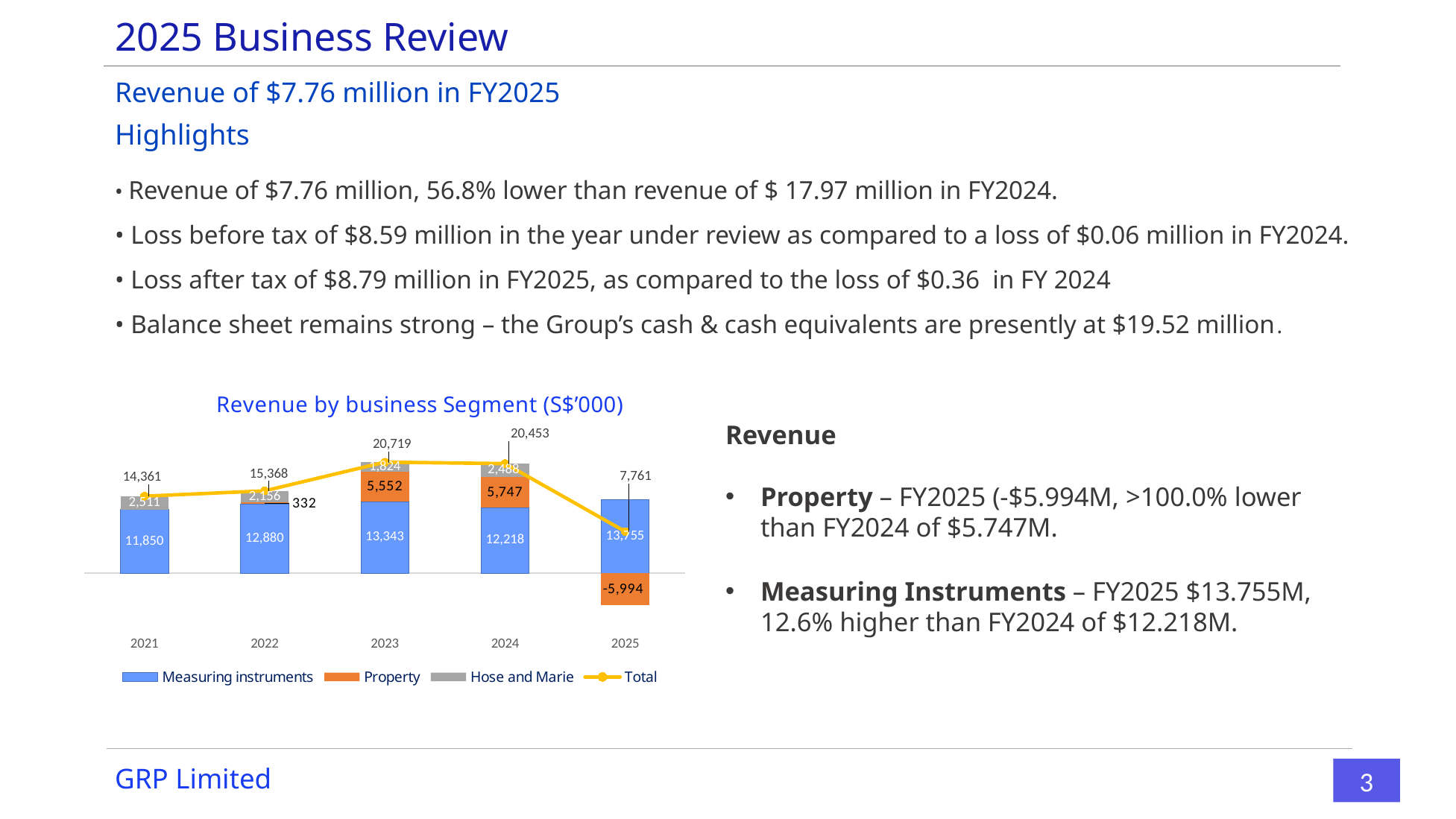
How many years are shown on the x axis of the chart? 5 What is the difference between the Total revenue in 2024 and 2025? 12,692 Which year has the highest Total revenue? 2023 What is the Measuring instruments revenue for 2023? 13,343 How many series does the chart legend list? 4 What is the Hose and Marie revenue for 2021? 2,511 Does the Total revenue rise or fall from 2024 to 2025? fall What is the title of the chart on the slide? Revenue by business Segment (S$'000) Which is larger, the Property revenue in 2023 or in 2024? 2024 What is the Property revenue for 2025? -5,994 What is the Total revenue for 2024? 20,453 Which year has the lowest Total revenue? 2025